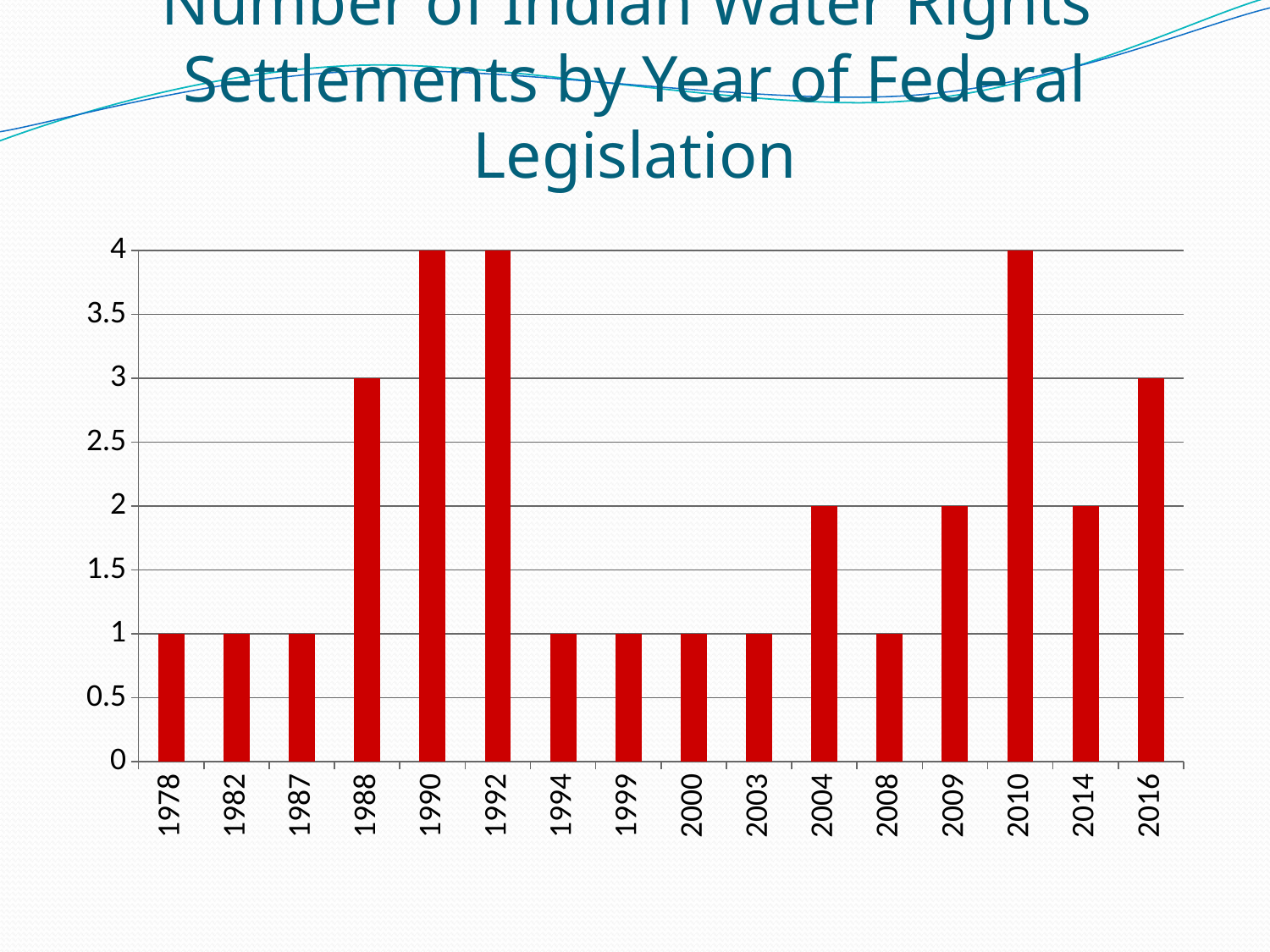
What is the difference between the values for 2010 and 2009? 2 What is the value for 1990? 4 How many years are shown on the x axis of the chart? 16 What is the difference between the values for 1990 and 1988? 1 What is the value for 1978? 1 Which has the larger value, 1988 or 2004? 1988 What is the value for 2004? 2 What is the value for 1988? 3 What is the value for 2016? 3 What kind of chart is shown on the slide? bar chart Is the value for 2014 greater or less than 3? less What is the highest value reached by any bar in the chart? 4